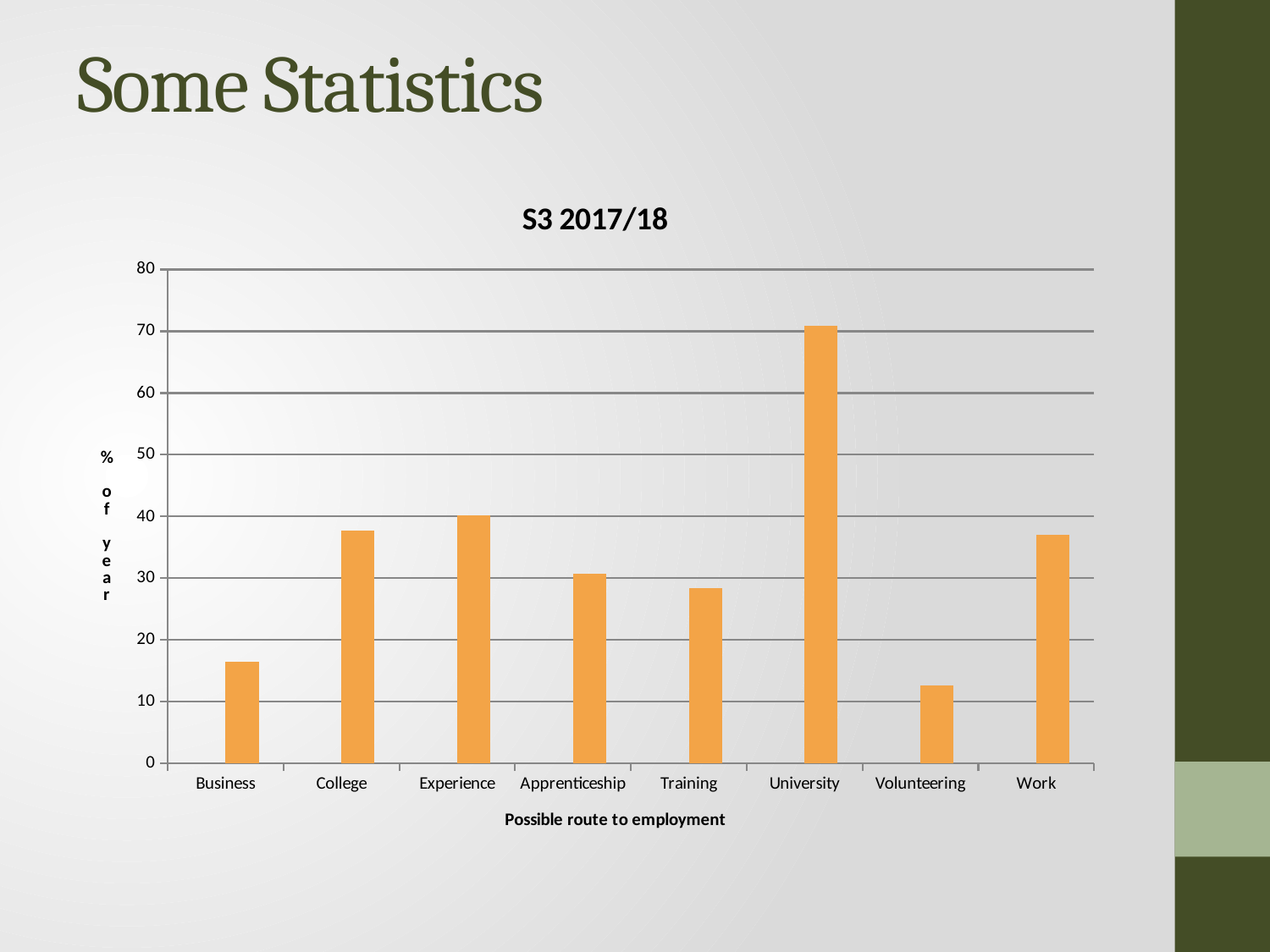
Which is larger, the value for Volunteering or the value for College? College Which route to employment has the highest percentage of the year? University Is the value for Training greater or less than 30? less Is the value for Business greater or less than 20? less How many possible routes to employment are shown on the x axis? 8 Which route to employment has the lowest percentage of the year? Volunteering What is the title of the chart? S3 2017/18 What kind of chart is shown on the slide? bar chart Which is larger, the value for Experience or the value for Training? Experience What is the label on the x axis of the chart? Possible route to employment